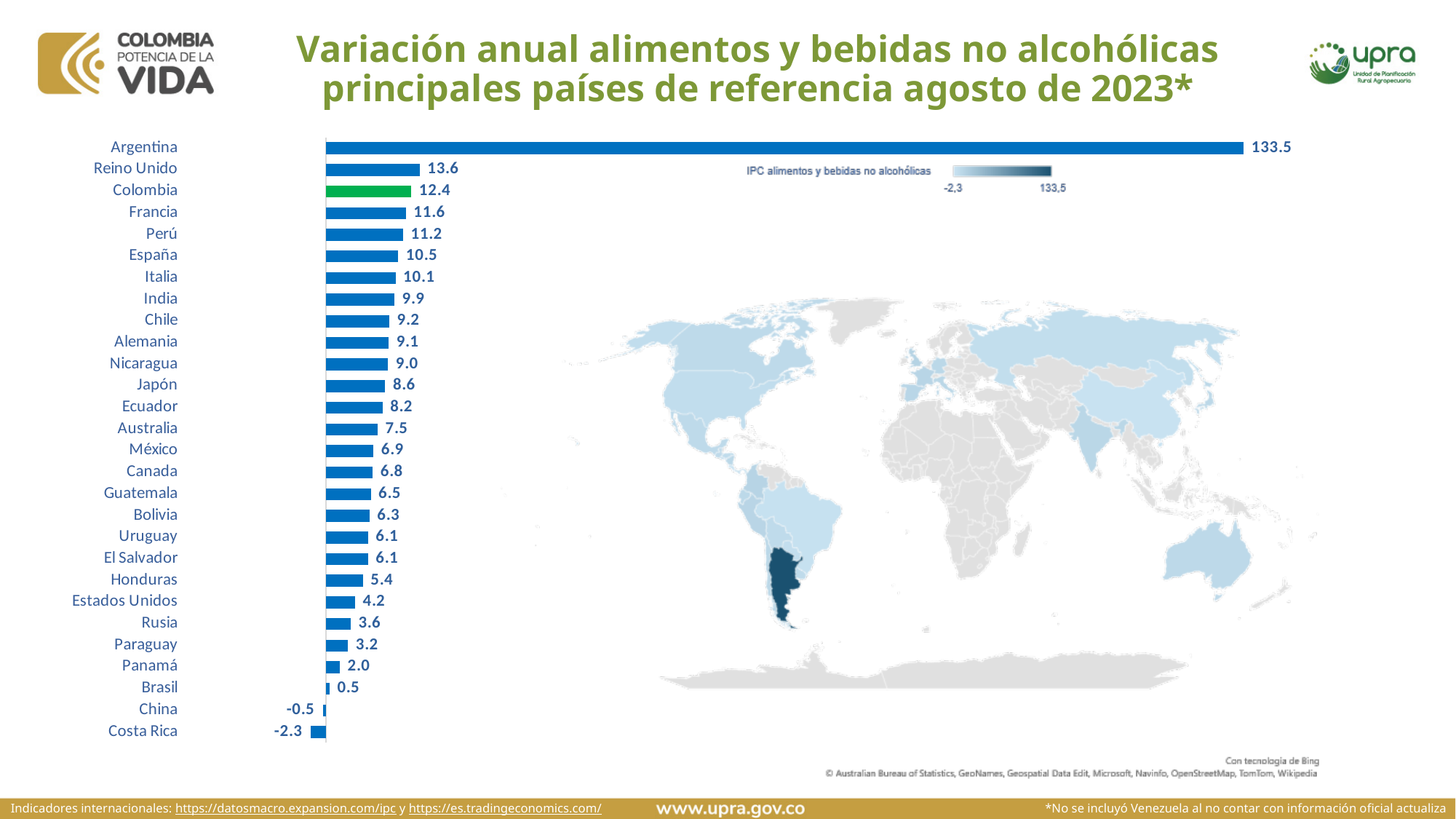
What kind of chart is used to show the values by country? Bar chart What is the difference between the values for Brasil and China? 1.0 Which country has the lowest value in the bar chart? Costa Rica Which country has the highest value in the bar chart? Argentina What is the value for Estados Unidos in the bar chart? 4.2 How many countries are shown in the bar chart? 28 Which country's bar is coloured green instead of blue? Colombia What is the value for Colombia in the bar chart? 12.4 Which has a larger value, Perú or Chile? Perú What is the difference between the values for Reino Unido and Colombia? 1.2 What is the value for Costa Rica in the bar chart? -2.3 What is the value for Argentina in the bar chart? 133.5